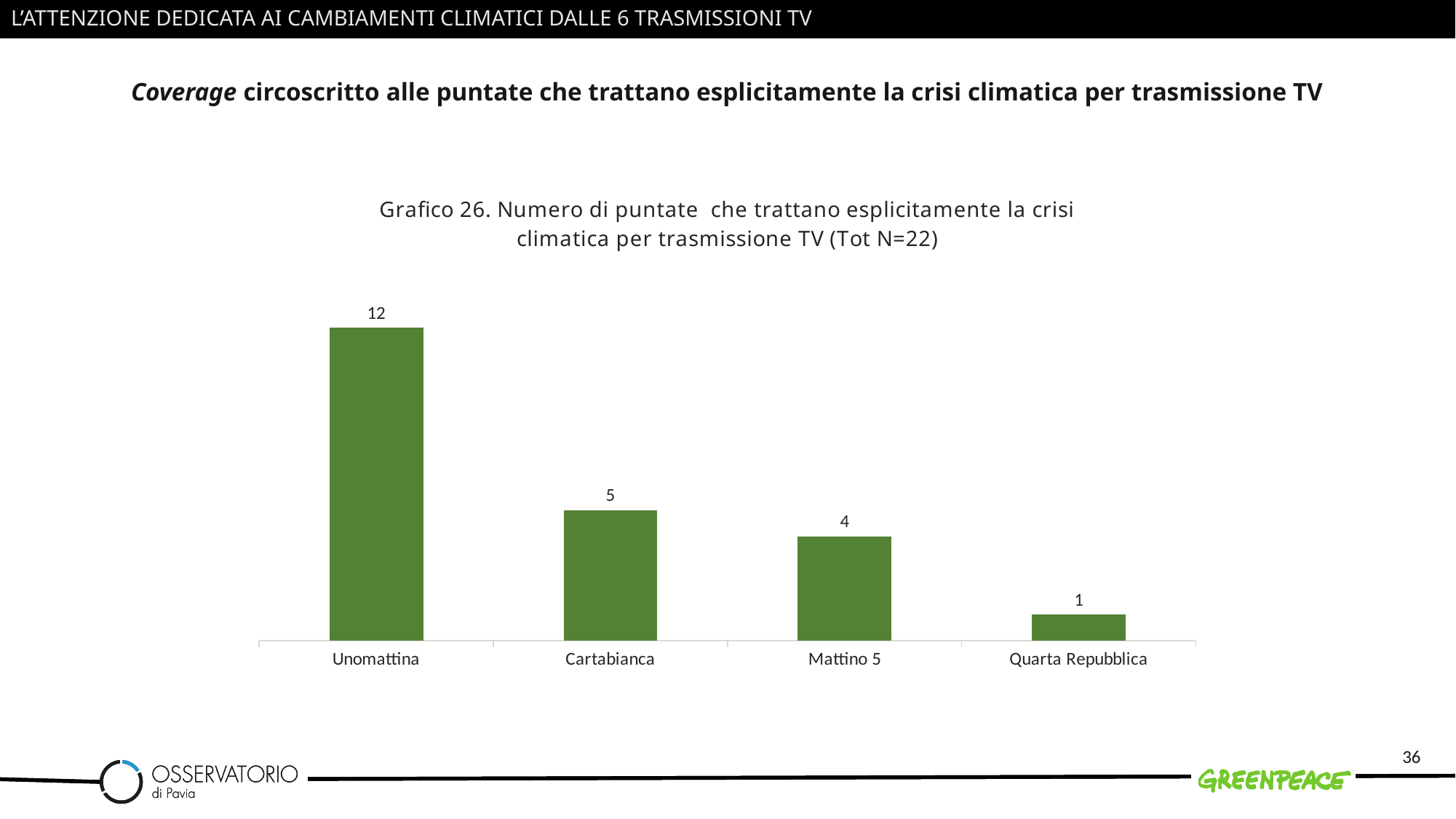
Which has a larger value, Cartabianca or Mattino 5? Cartabianca What is the value shown for Cartabianca? 5 Which TV programme has the highest number of episodes explicitly addressing the climate crisis? Unomattina How many TV programmes are shown on the chart? 4 What is the value shown for Quarta Repubblica? 1 What is the difference between the values for Unomattina and Cartabianca? 7 Which TV programme has the lowest number of episodes explicitly addressing the climate crisis? Quarta Repubblica What kind of chart is shown on the slide? Bar chart What is the value shown for Mattino 5? 4 How many episodes explicitly addressing the climate crisis does Unomattina have? 12 What total N is stated in the chart title? 22 What is the difference between the values for Mattino 5 and Quarta Repubblica? 3